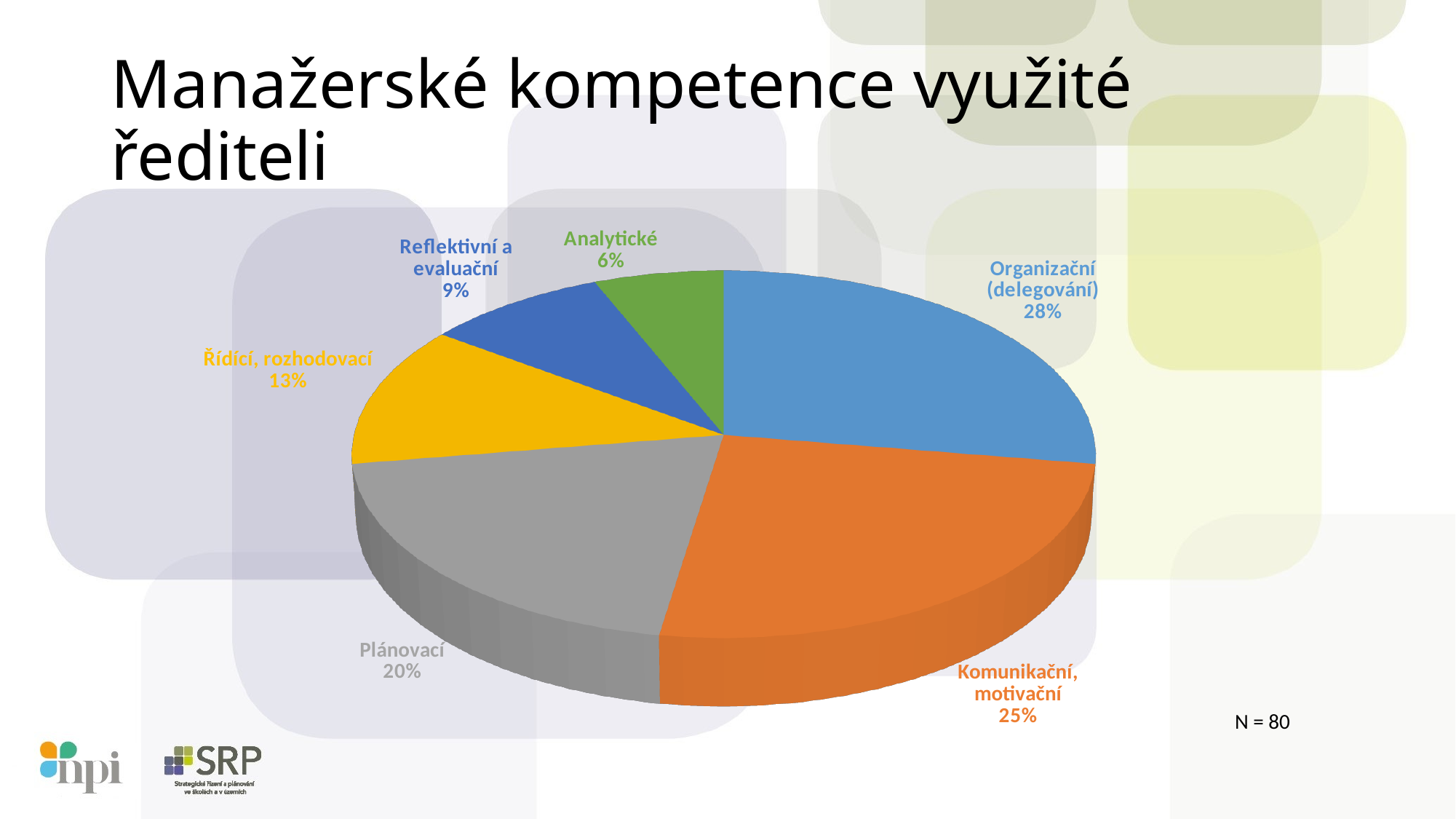
How many categories are shown in the pie chart? 6 Which category has the smallest slice of the pie? Analytické What share of the pie does the 'Organizační (delegování)' slice represent? 28% Which is larger, 'Plánovací' or 'Řídící, rozhodovací'? Plánovací What kind of chart is shown on the slide? Pie chart What percentage is shown for 'Reflektivní a evaluační'? 9% What percentage is shown for 'Komunikační, motivační'? 25% What is the difference in percentage points between 'Organizační (delegování)' and 'Analytické'? 22 What sample size (N) is stated on the slide? N = 80 What percentage is shown for 'Řídící, rozhodovací'? 13% What percentage is shown for 'Plánovací'? 20% Which category has the largest slice of the pie? Organizační (delegování)